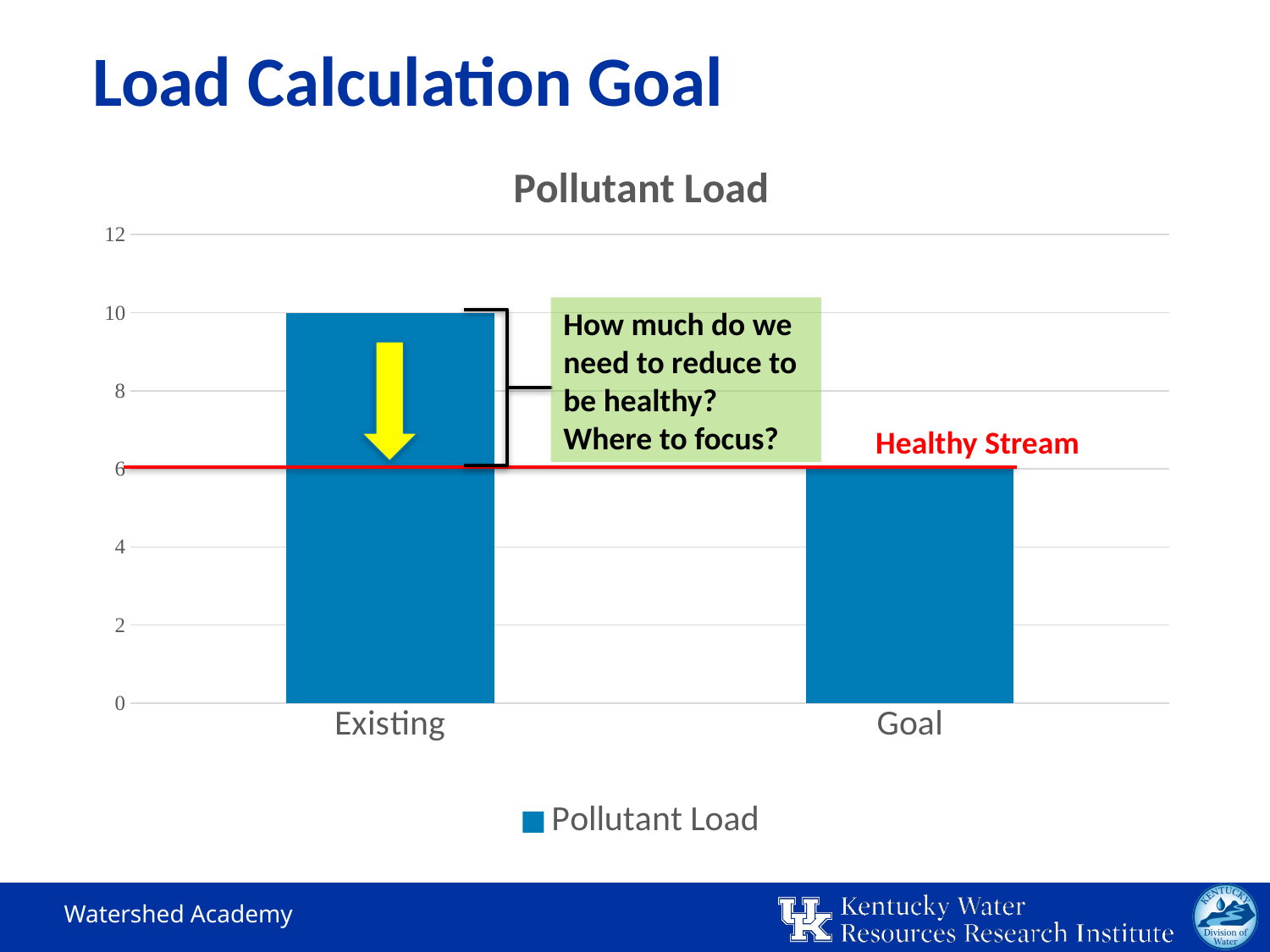
What is the difference between the Pollutant Load for Existing and for Goal? 4 Which is larger, the Pollutant Load for Existing or for Goal? Existing Do the values rise or fall from Existing to Goal along the x axis? fall Is the Pollutant Load value for Existing greater or less than 8? greater Which category has the lowest Pollutant Load? Goal What is the Pollutant Load value for Existing? 10 What is the title of the chart? Pollutant Load How many series does the legend list? 1 What is the Pollutant Load value for Goal? 6 What type of chart is shown on the slide? bar chart How many categories are shown on the x axis of the chart? 2 Which category has the highest Pollutant Load? Existing